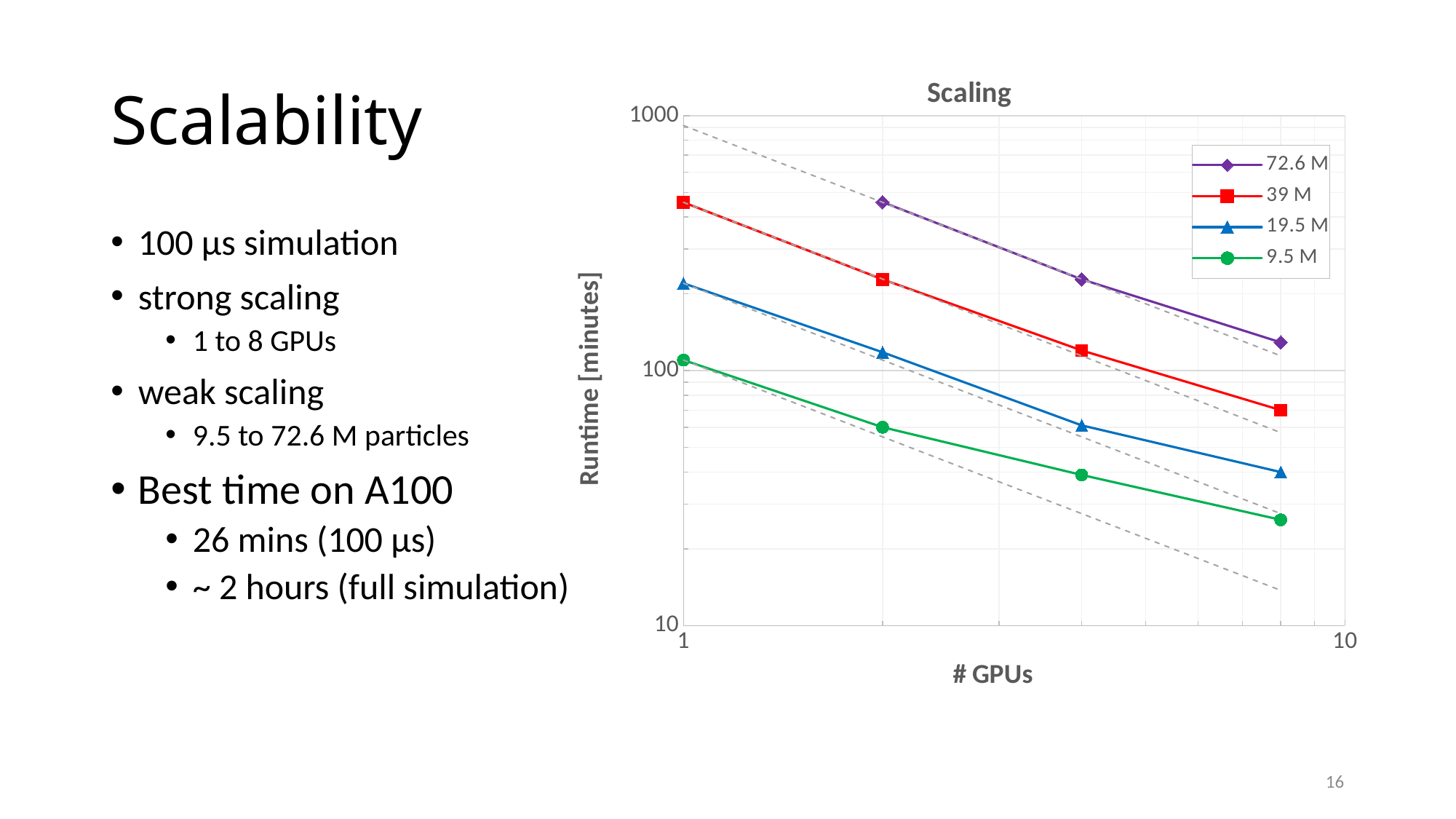
How many series does the legend of the Scaling chart list? 4 Which series has the lowest runtime across the chart? 9.5 M Is the runtime for the 39 M series at its rightmost point greater or less than 100 minutes? less Does the runtime rise or fall as the number of GPUs increases? fall What kind of chart is shown on the slide? line chart Which series has the highest runtime at the largest number of GPUs plotted? 72.6 M Is the runtime for the 9.5 M series at its rightmost point greater or less than 100 minutes? less What is the label of the y axis of the chart? Runtime [minutes] Is the runtime for the 19.5 M series at 1 GPU greater or less than 100 minutes? greater What is the title of the chart? Scaling How many data points are plotted for the 9.5 M series? 4 At the second data point from the left, which series has the larger runtime, 39 M or 19.5 M? 39 M